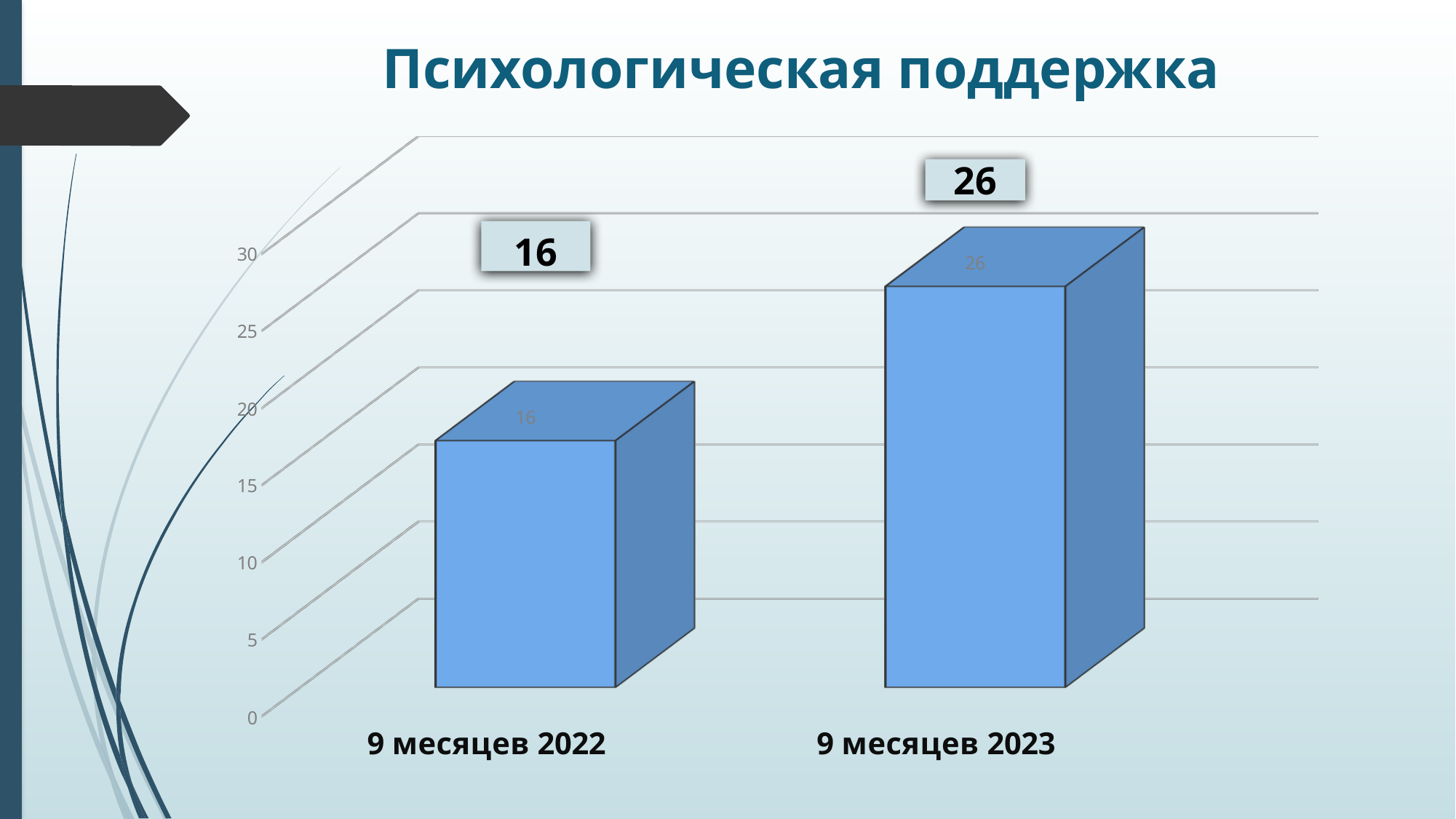
Is the value for 9 месяцев 2023 greater or less than 20? greater How many categories are shown on the chart? 2 What kind of chart is shown on the slide? bar chart What is the title of the slide? Психологическая поддержка What is the value for 9 месяцев 2022? 16 Which is larger, the value for 9 месяцев 2022 or for 9 месяцев 2023? 9 месяцев 2023 Which category has the highest value? 9 месяцев 2023 What is the difference between the values for 9 месяцев 2023 and 9 месяцев 2022? 10 What is the value for 9 месяцев 2023? 26 Which category has the lowest value? 9 месяцев 2022 Do the values rise or fall from 9 месяцев 2022 to 9 месяцев 2023? rise Is the value for 9 месяцев 2022 greater or less than 20? less